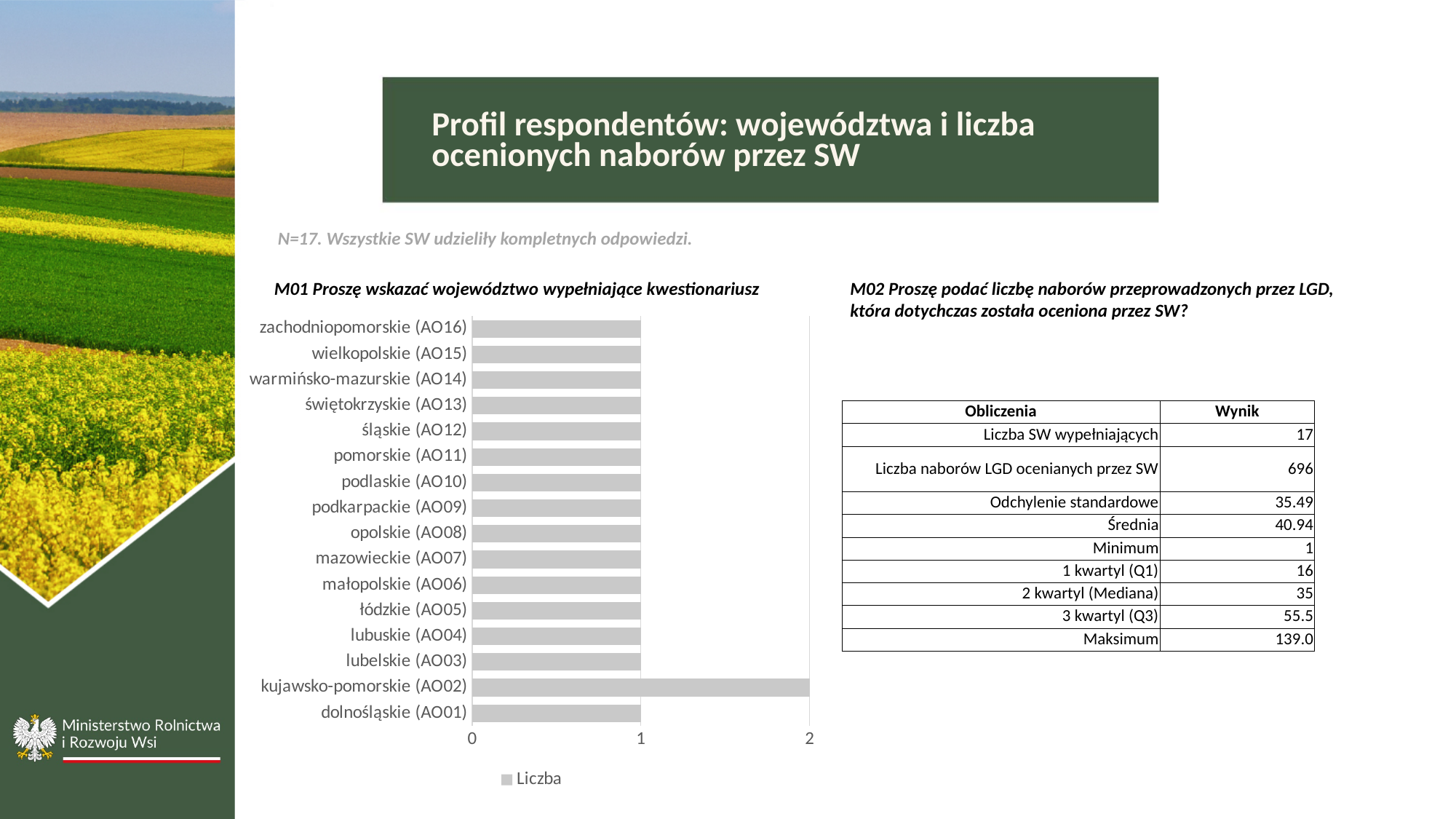
What is the name of the series shown in the chart legend? Liczba What is the difference between the values for kujawsko-pomorskie (AO02) and lubelskie (AO03)? 1 Is the value for kujawsko-pomorskie (AO02) greater or less than 1? greater Which has the larger value, kujawsko-pomorskie (AO02) or mazowieckie (AO07)? kujawsko-pomorskie (AO02) What is the value for kujawsko-pomorskie (AO02) in the bar chart? 2 What is the title of the bar chart? M01 Proszę wskazać województwo wypełniające kwestionariusz What is the value for zachodniopomorskie (AO16) in the bar chart? 1 What kind of chart is shown on the slide? bar chart How many series does the chart legend list? 1 What is the value for dolnośląskie (AO01) in the bar chart? 1 Which voivodeship has the highest value in the bar chart? kujawsko-pomorskie (AO02) How many voivodeship categories are plotted in the bar chart? 16